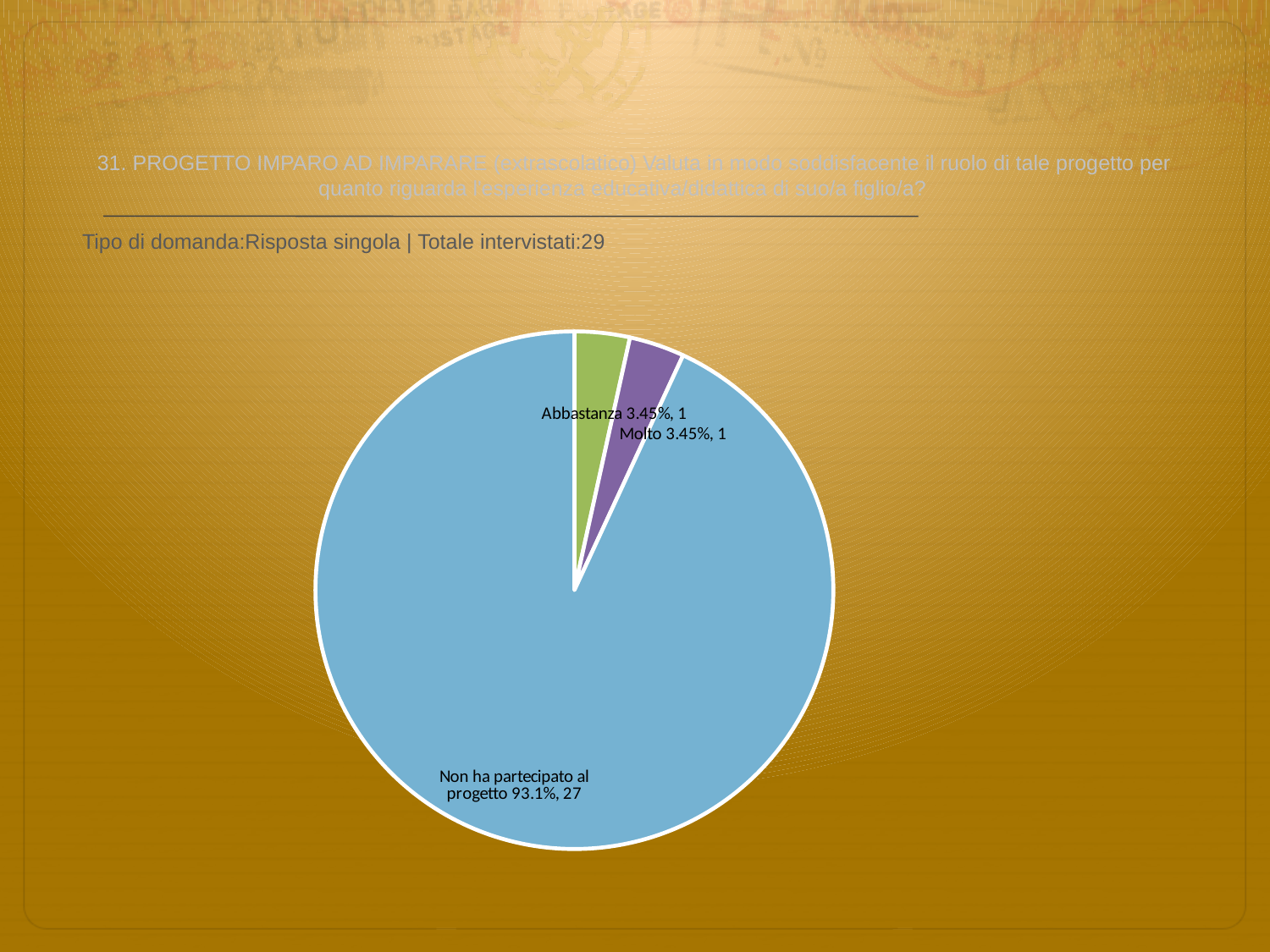
What is the total number of respondents (Totale intervistati) stated on the slide? 29 What is the difference in respondent count between 'Non ha partecipato al progetto' and 'Abbastanza'? 26 What percentage share does the 'Molto' slice have? 3.45% How many slices does the pie chart have? 3 Which is larger, the 'Non ha partecipato al progetto' slice or the 'Molto' slice? Non ha partecipato al progetto What colour is the 'Non ha partecipato al progetto' slice? light blue What kind of chart is shown on the slide? pie chart What percentage share does the 'Abbastanza' slice have? 3.45% Which slice of the pie chart is the largest? Non ha partecipato al progetto How many respondents are counted in the 'Non ha partecipato al progetto' slice? 27 How many respondents are counted in the 'Molto' slice? 1 What percentage share does the 'Non ha partecipato al progetto' slice have? 93.1%